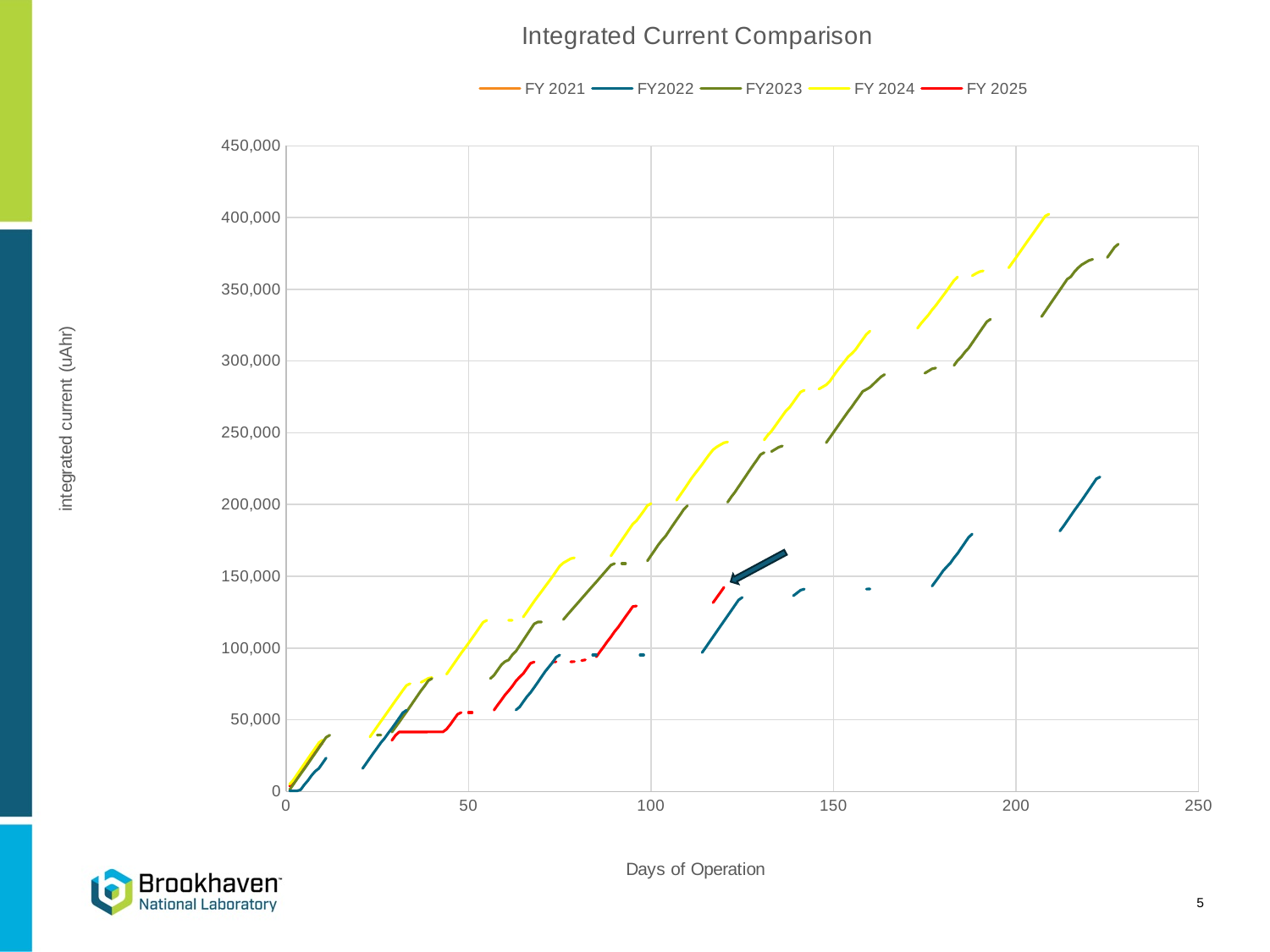
At 100 days of operation, which series has the larger integrated current, FY 2024 or FY2023? FY 2024 Do the integrated current values rise or fall as days of operation increase? rise How many series does the legend list? 5 Which series reaches the highest integrated current on the chart? FY 2024 Is the value for FY 2024 at 200 days of operation greater or less than 350,000? greater What is the title of the chart? Integrated Current Comparison Is the value for FY 2024 at 150 days of operation greater or less than 250,000? greater Is the value for FY 2025 at 40 days of operation greater or less than 50,000? less What is the label of the x axis? Days of Operation What kind of chart is shown on the slide? line chart